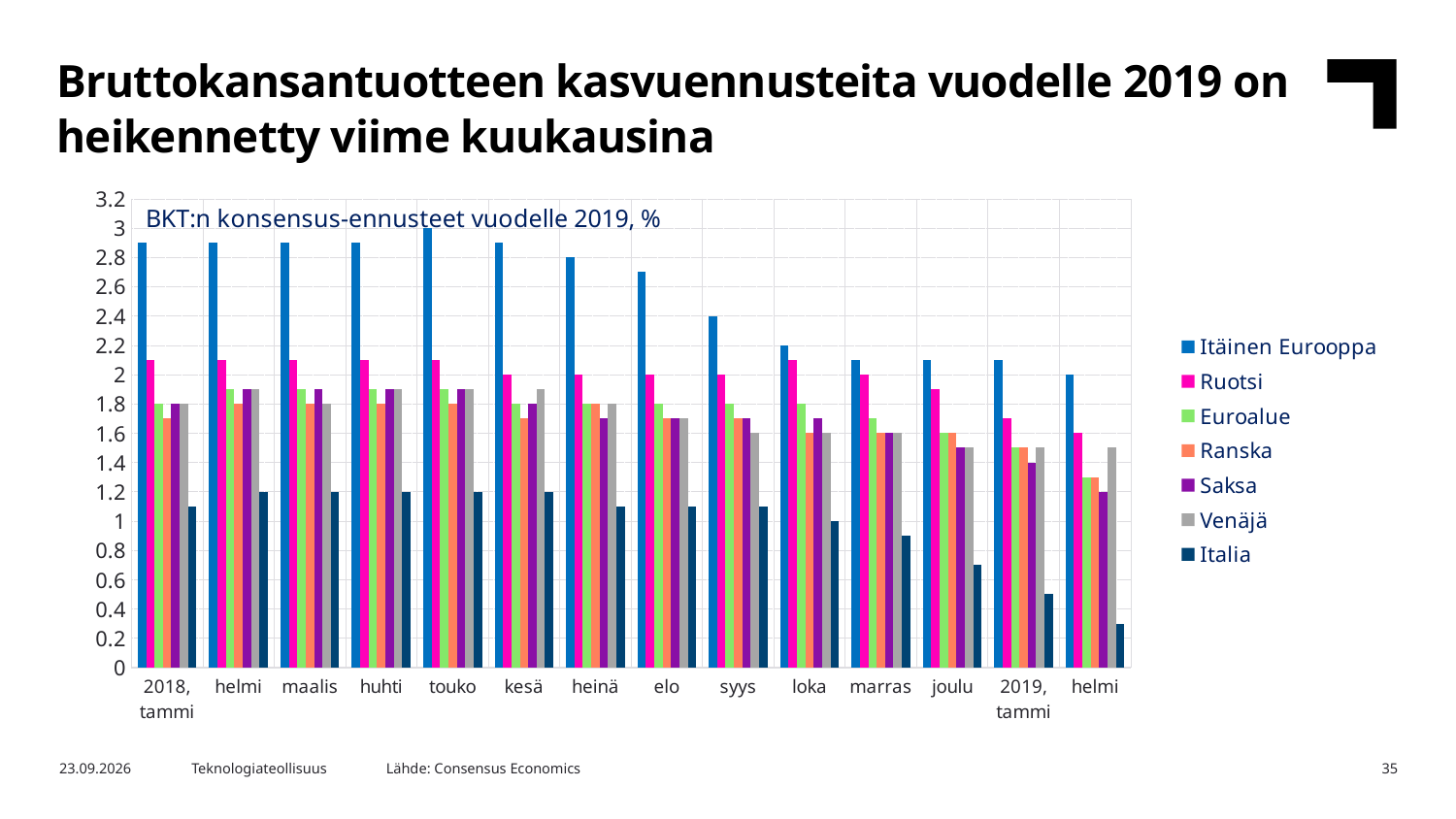
How many month categories are shown along the x axis? 14 Which series has the lowest value in 2018, tammi? Italia What is the title printed inside the chart area? BKT:n konsensus-ennusteet vuodelle 2019, % Which series is listed first in the legend? Itäinen Eurooppa Do the values for Italia rise or fall from 2018, tammi to 2019, helmi? fall What kind of chart is shown on the slide? bar chart Is the value for Ruotsi in 2019, helmi greater or less than 1.8? less Is the value for Itäinen Eurooppa in 2018, tammi greater or less than 2.6? greater Which series has the highest value in 2018, tammi? Itäinen Eurooppa Is the value for Italia in 2019, helmi greater or less than 0.4? less Which is larger in touko: the value for Itäinen Eurooppa or the value for Italia? Itäinen Eurooppa How many series does the legend list? 7